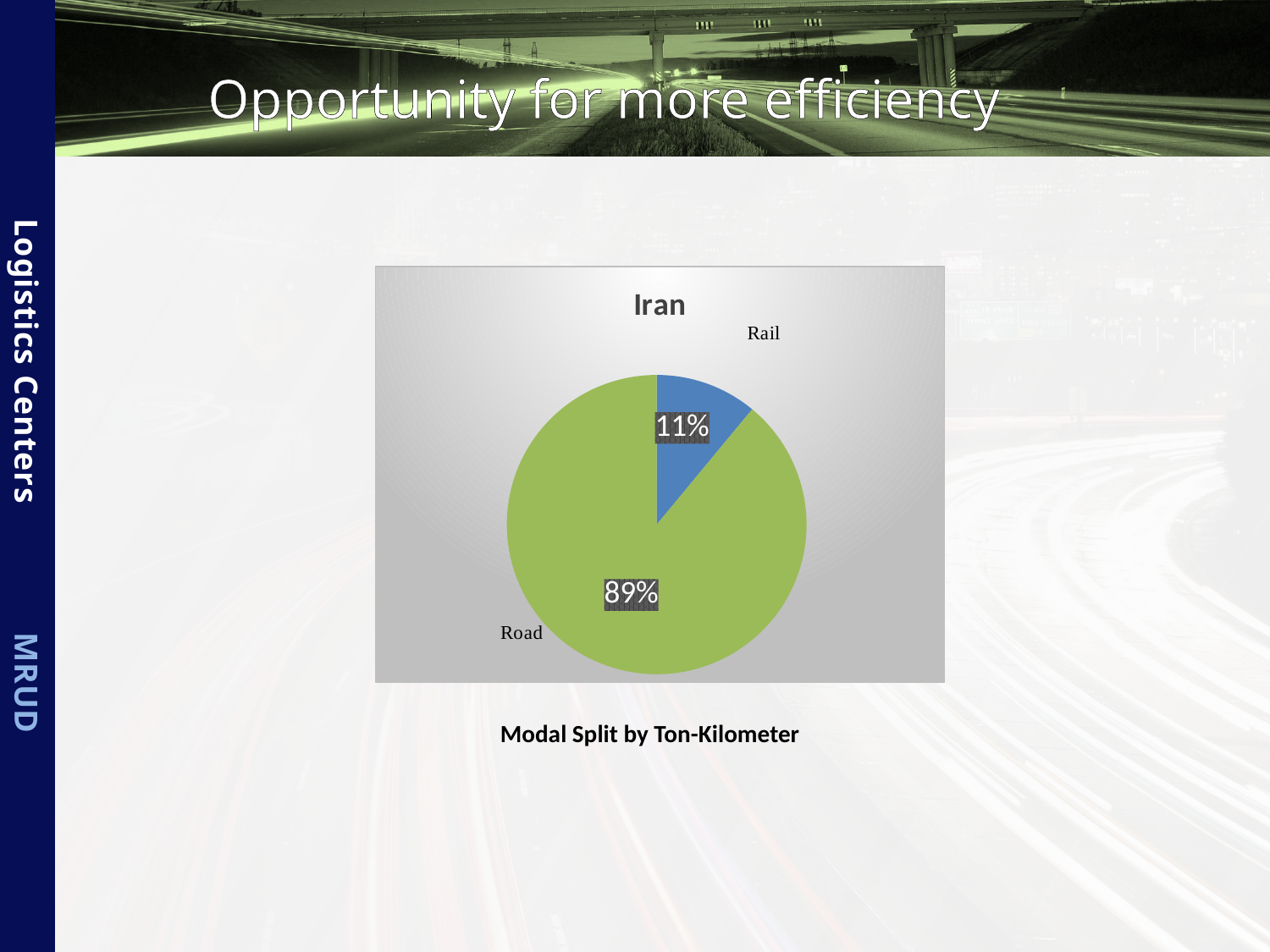
Which slice of the pie is the largest? Road What is the chart's title? Iran What share of the pie does Road account for? 89% How many slices does the pie chart have? 2 What type of chart is shown on the slide? pie chart What colour is the Rail slice? blue Which slice of the pie is the smallest? Rail Which is larger, the Road share or the Rail share? Road What is the caption below the chart? Modal Split by Ton-Kilometer What is the difference in percentage points between the Road and Rail shares? 78 What share of the pie does Rail account for? 11%